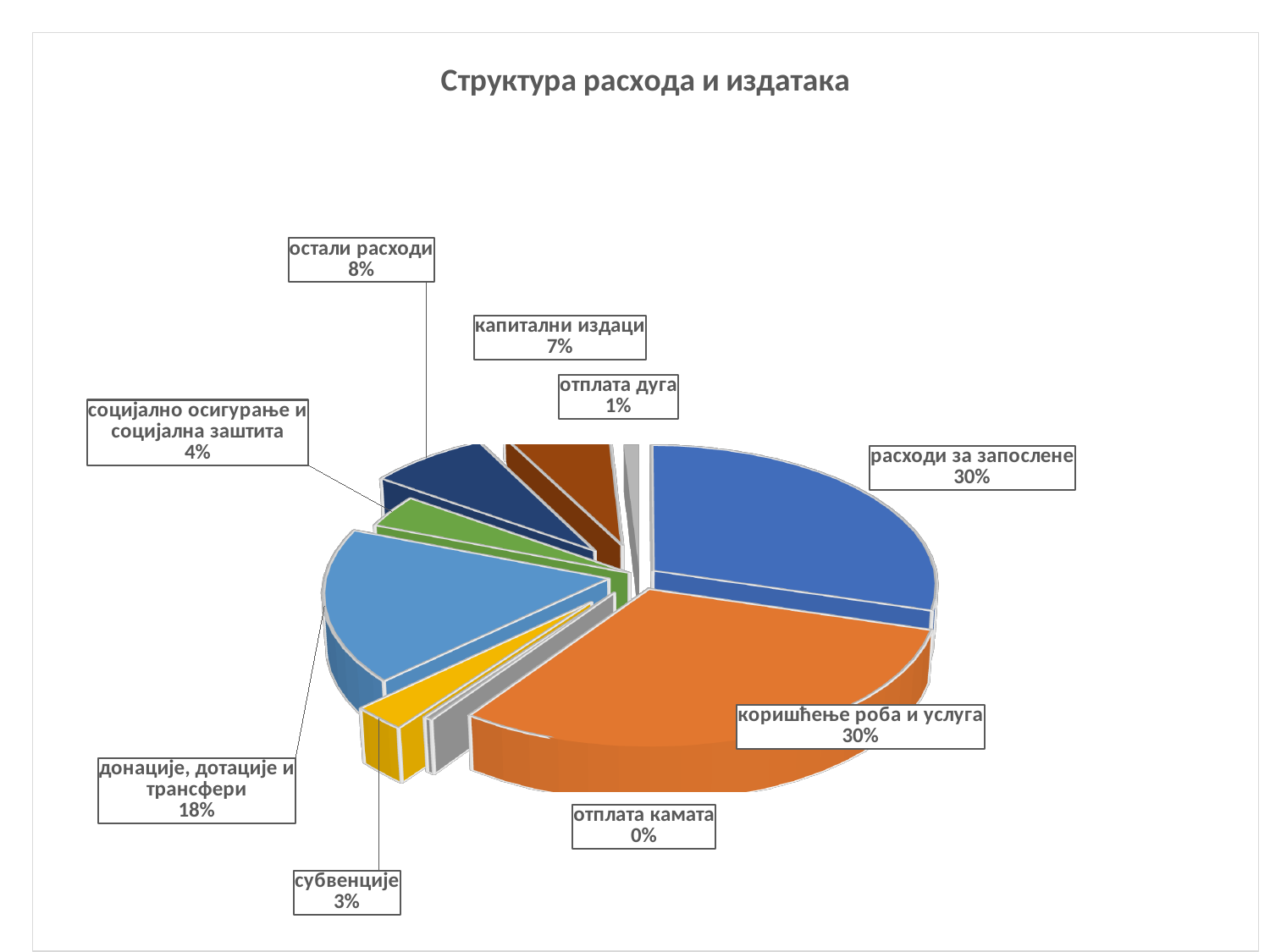
What is the title of the chart? Структура расхода и издатака What percentage is shown for 'отплата дуга'? 1% What share of the pie is labelled for 'донације, дотације и трансфери'? 18% How many categories (slices) are labelled on the pie chart? 9 What kind of chart is shown on the slide? pie chart What percentage is shown for 'субвенције'? 3% What percentage is shown for 'социјално осигурање и социјална заштита'? 4% What percentage is shown for 'капитални издаци'? 7% Which is larger, the share for 'остали расходи' or the share for 'капитални издаци'? остали расходи What percentage is shown for 'остали расходи'? 8% What is the difference in percentage points between 'расходи за запослене' and 'донације, дотације и трансфери'? 12 Which category has the smallest share of the pie? отплата камата